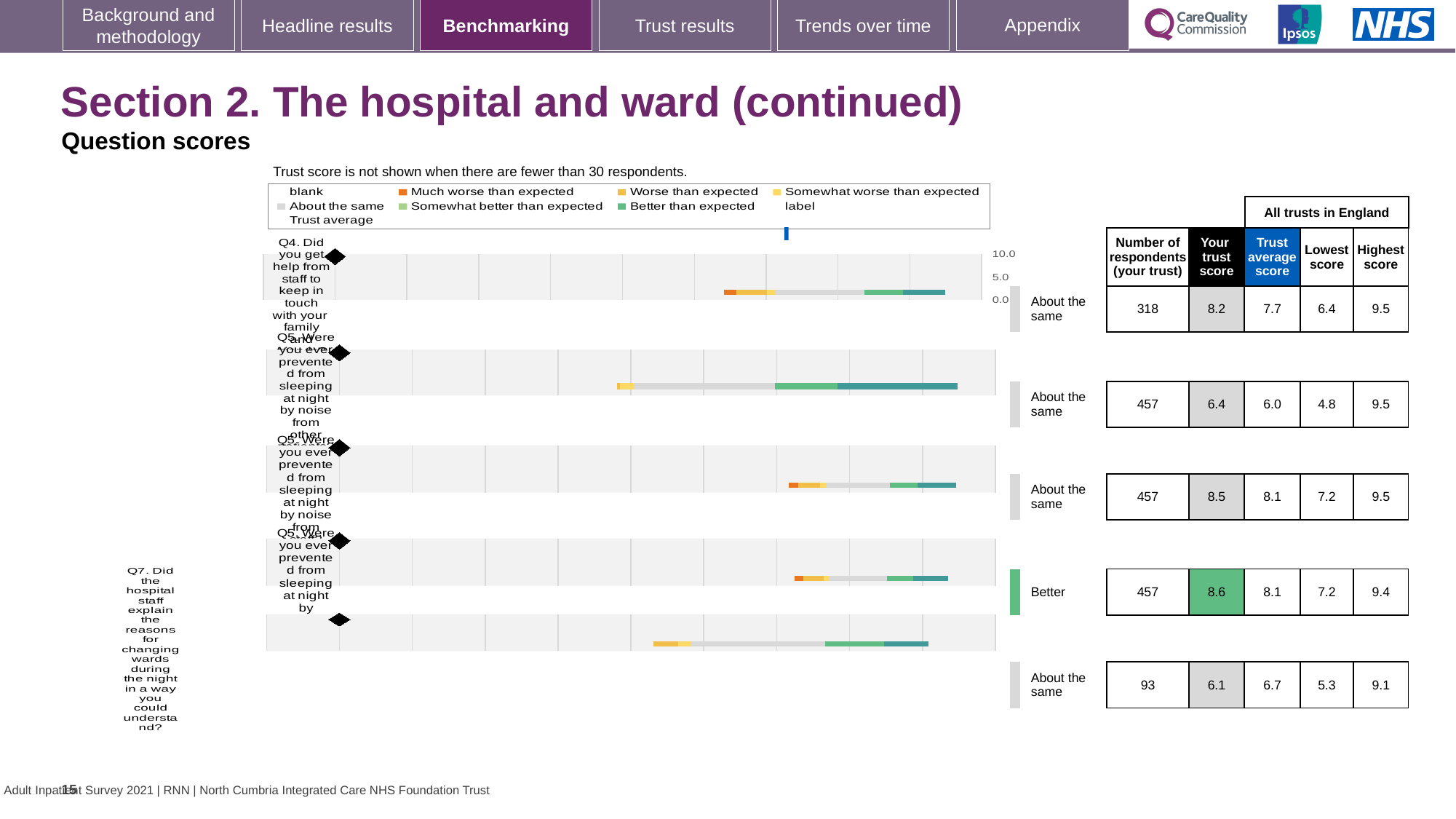
In the table beside the chart, is the trust score for the last row (6.1) larger or smaller than its trust average score (6.7)? smaller In the table beside the chart, how many respondents are listed for the first row (Q4)? 318 What is the maximum value shown on the chart's score axis? 10.0 Which legend entry is shown in grey in the chart legend? About the same How many of the chart rows are rated 'Better' rather than 'About the same'? 1 What kind of chart is used to show the question scores on this slide? bar chart In the table beside the chart, what is the 'Highest score' for the first row (Q4)? 9.5 In the table beside the chart, what is the 'Your trust score' value for the first row (Q4)? 8.2 In the table beside the chart, what is the 'Your trust score' value for the last row (93 respondents)? 6.1 How many question rows (bars) are plotted in the benchmarking chart? 5